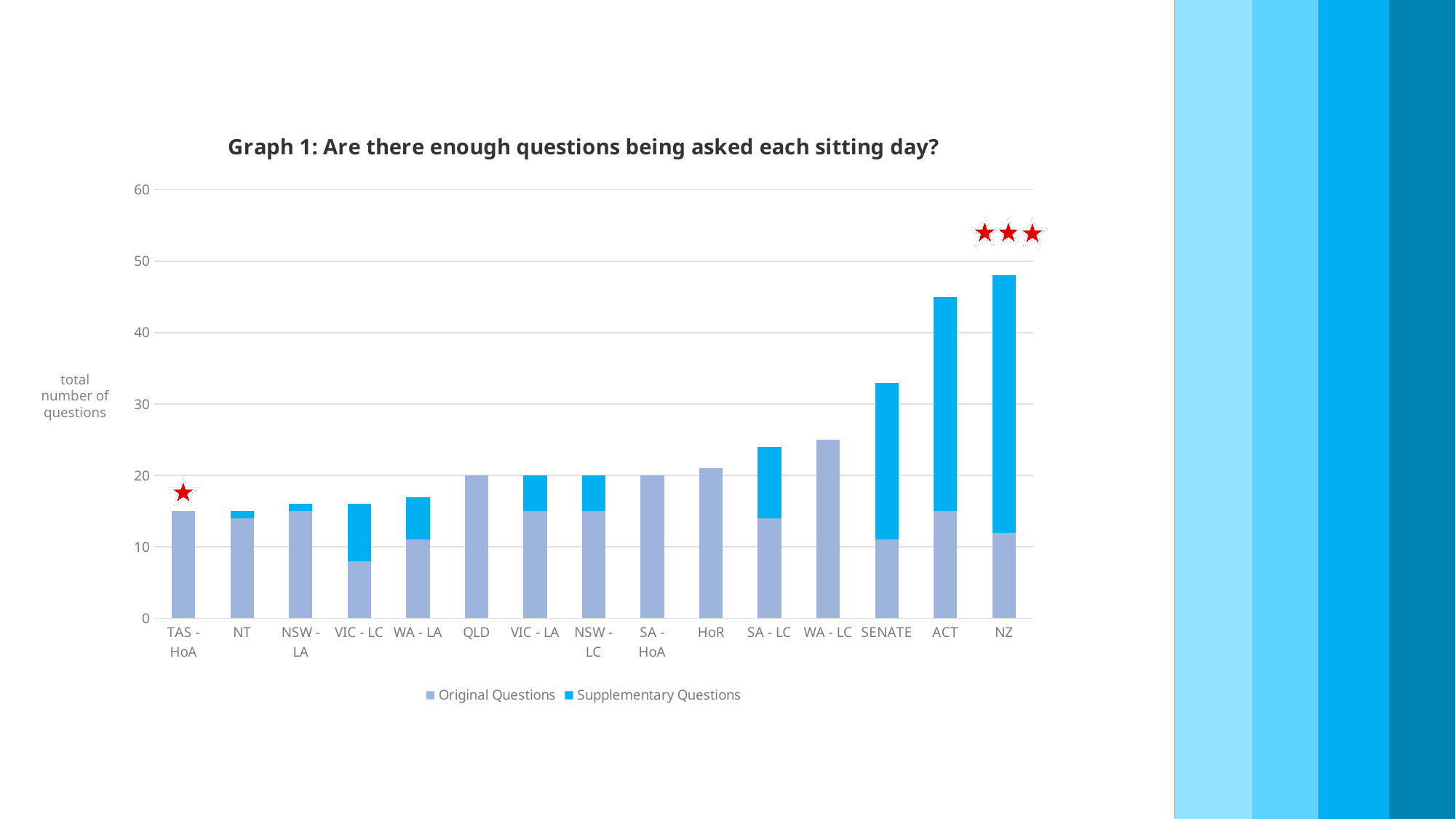
What kind of chart is shown on the slide? Stacked bar chart Do the bar totals generally rise or fall moving from left to right along the x axis? Rise What is the title of the chart? Graph 1: Are there enough questions being asked each sitting day? Which category has the highest total number of questions? NZ Is the total for TAS - HoA greater or less than 20? less How many categories are shown along the x axis? 15 Is the total for WA - LC greater or less than 20? greater How many series does the legend list? 2 Which has a larger total, SENATE or ACT? ACT What are the two series named in the legend? Original Questions and Supplementary Questions Is the total for SENATE greater or less than 30? greater